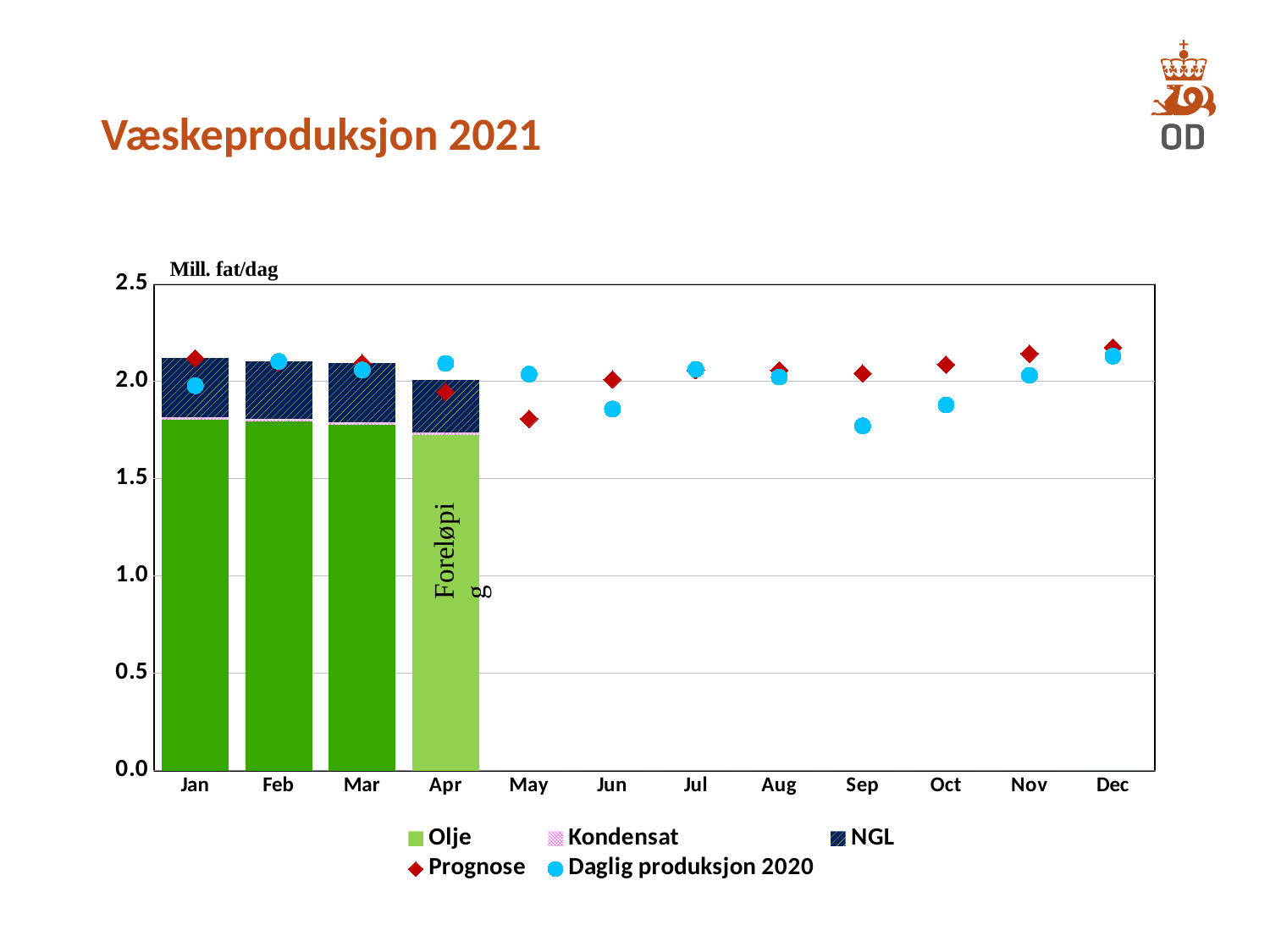
Is the Daglig produksjon 2020 value for Sep greater or less than 2.0? less How many months are shown on the x axis of the chart? 12 In May, which is larger: Prognose or Daglig produksjon 2020? Daglig produksjon 2020 What unit is shown on the y axis of the chart? Mill. fat/dag How many series does the chart's legend list? 5 In which month is the Daglig produksjon 2020 value lowest? Sep What kind of chart is shown on the slide? combination bar and line chart (stacked bars with markers) Is the Prognose value for May greater or less than 2.0? less Is the Olje value for Jan greater or less than 1.5? greater How many months have stacked bars plotted in the chart? 4 In which month is the Prognose value lowest? May